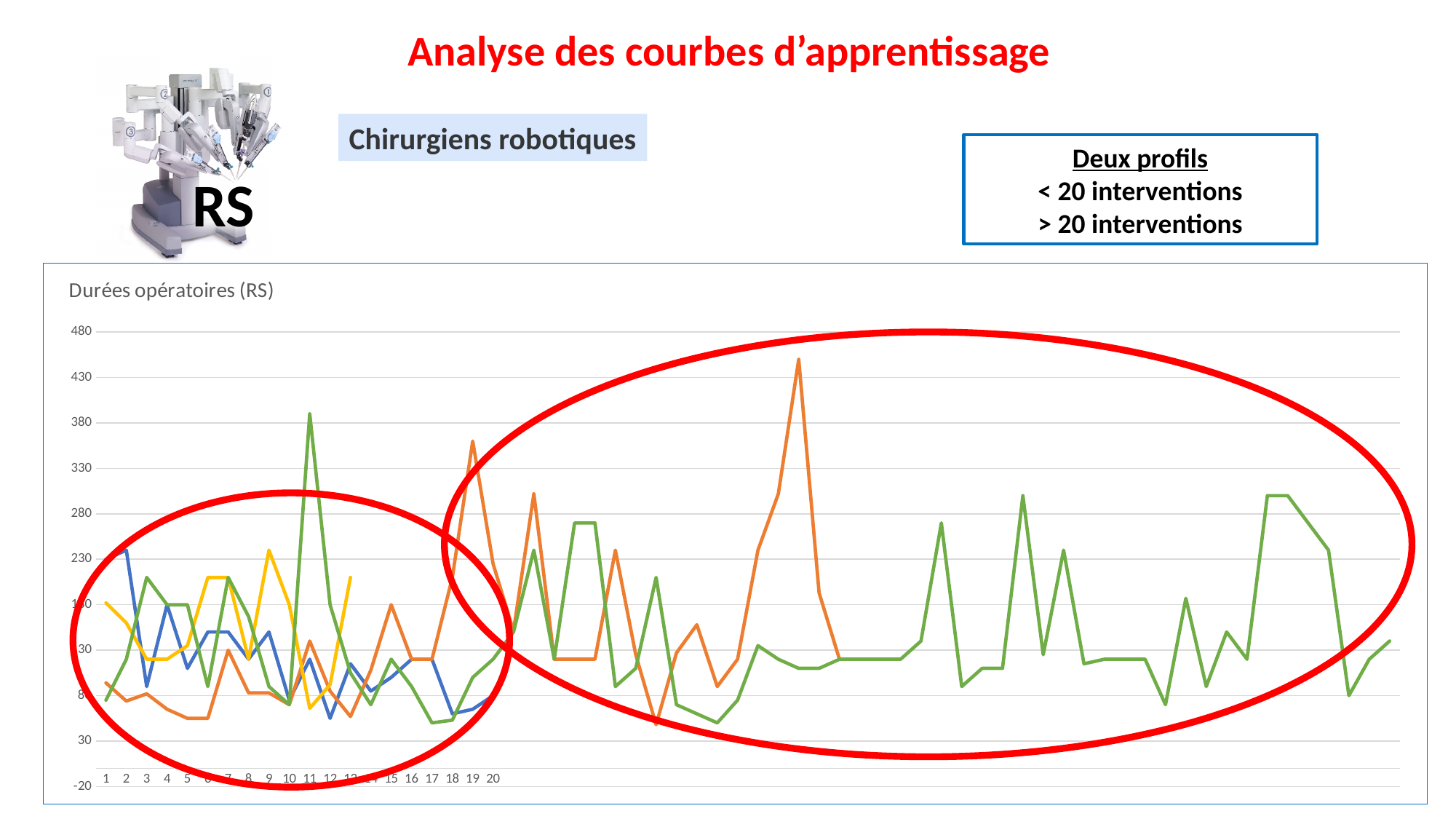
Is the value of the yellow line at intervention 9 greater or less than 180? greater Is the highest peak of the orange line greater or less than 430? greater Is the value of the blue line at intervention 12 greater or less than 80? less What is the title of the chart? Durées opératoires (RS) How many coloured lines are plotted on the chart? 4 Which line reaches the highest value on the chart, the orange line or the blue line? orange line What is the highest value shown on the y axis? 480 What kind of chart is shown on the slide? line chart